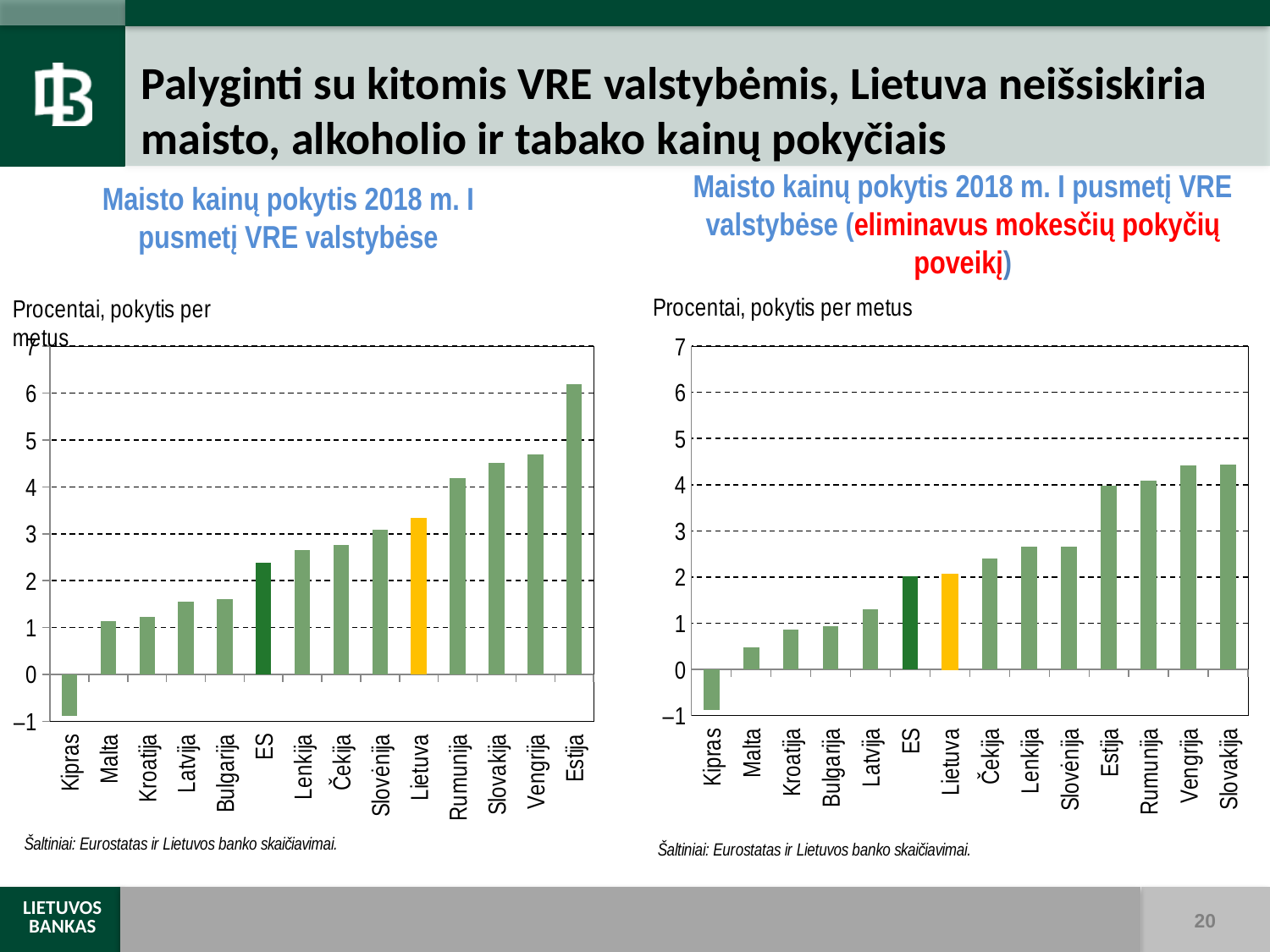
In the right chart (eliminavus mokesčių pokyčių poveikį), which country has the lowest value? Kipras In the left chart, is the value for Lietuva greater or less than 3? greater In the left chart, which is larger, the value for Lietuva or the value for ES? Lietuva In the left chart, which country has the highest value? Estija What kind of chart is the left chart, 'Maisto kainų pokytis 2018 m. I pusmetį VRE valstybėse'? Bar chart In the left chart, is the value for Estija greater or less than 6? greater In the right chart, is the value for Čekija greater or less than 2? greater In the right chart, which is larger, the value for Lietuva or the value for Čekija? Čekija In the left chart, which country has the lowest value? Kipras How many countries/categories are shown in the left chart? 14 In the right chart, do the values generally rise or fall from left to right along the x axis? Rise